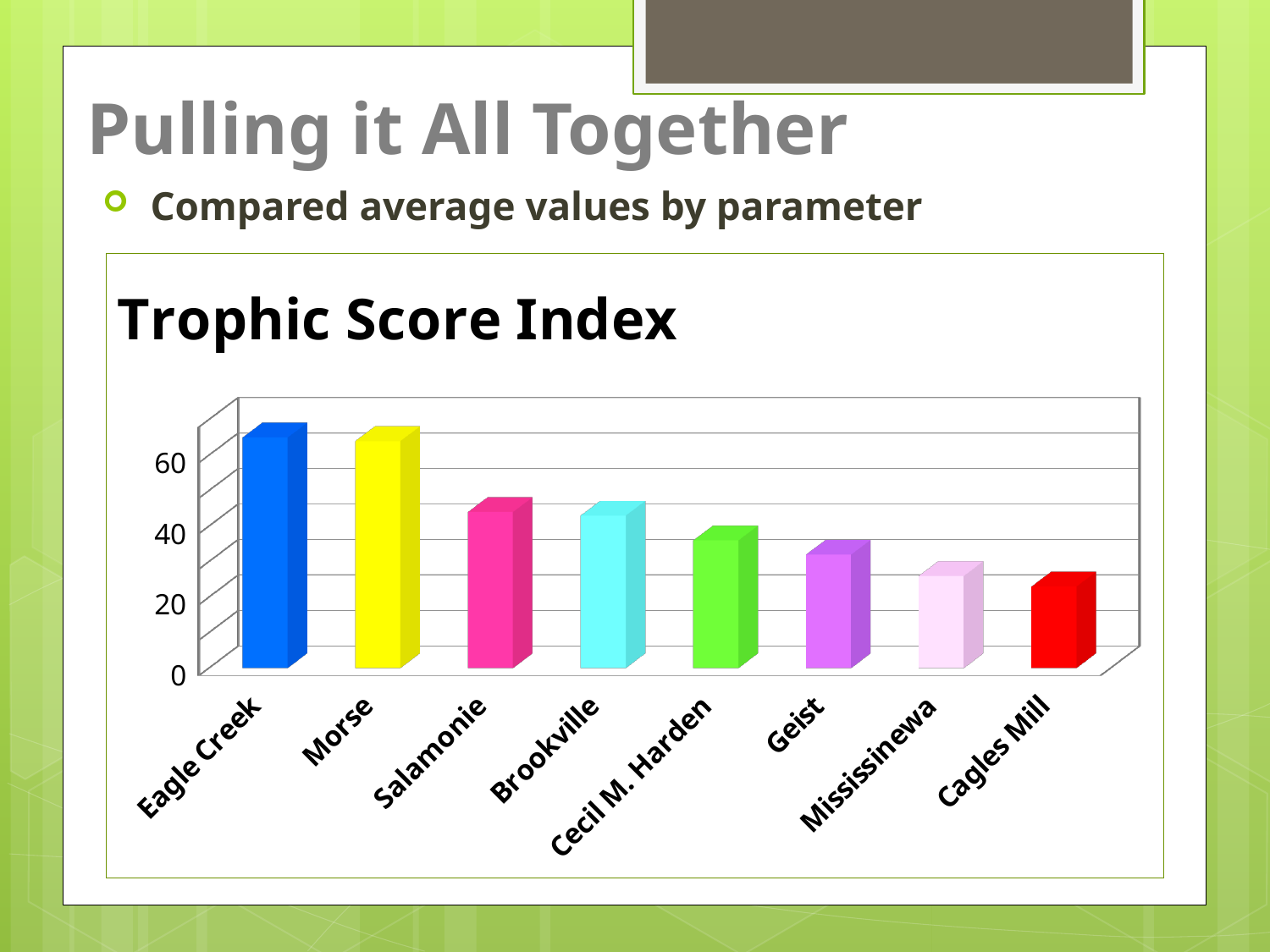
Is the value for Geist greater or less than 40? less Is the value for Eagle Creek greater or less than 60? greater Which category has the lowest value in the chart? Cagles Mill Is the value for Mississinewa greater or less than 40? less Do the values generally rise or fall from left to right across the categories? fall How many categories are plotted in the chart? 8 What kind of chart is shown on the slide? bar chart Which is larger, the value for Morse or the value for Brookville? Morse What is the title of the chart? Trophic Score Index Which is larger, the value for Salamonie or the value for Geist? Salamonie